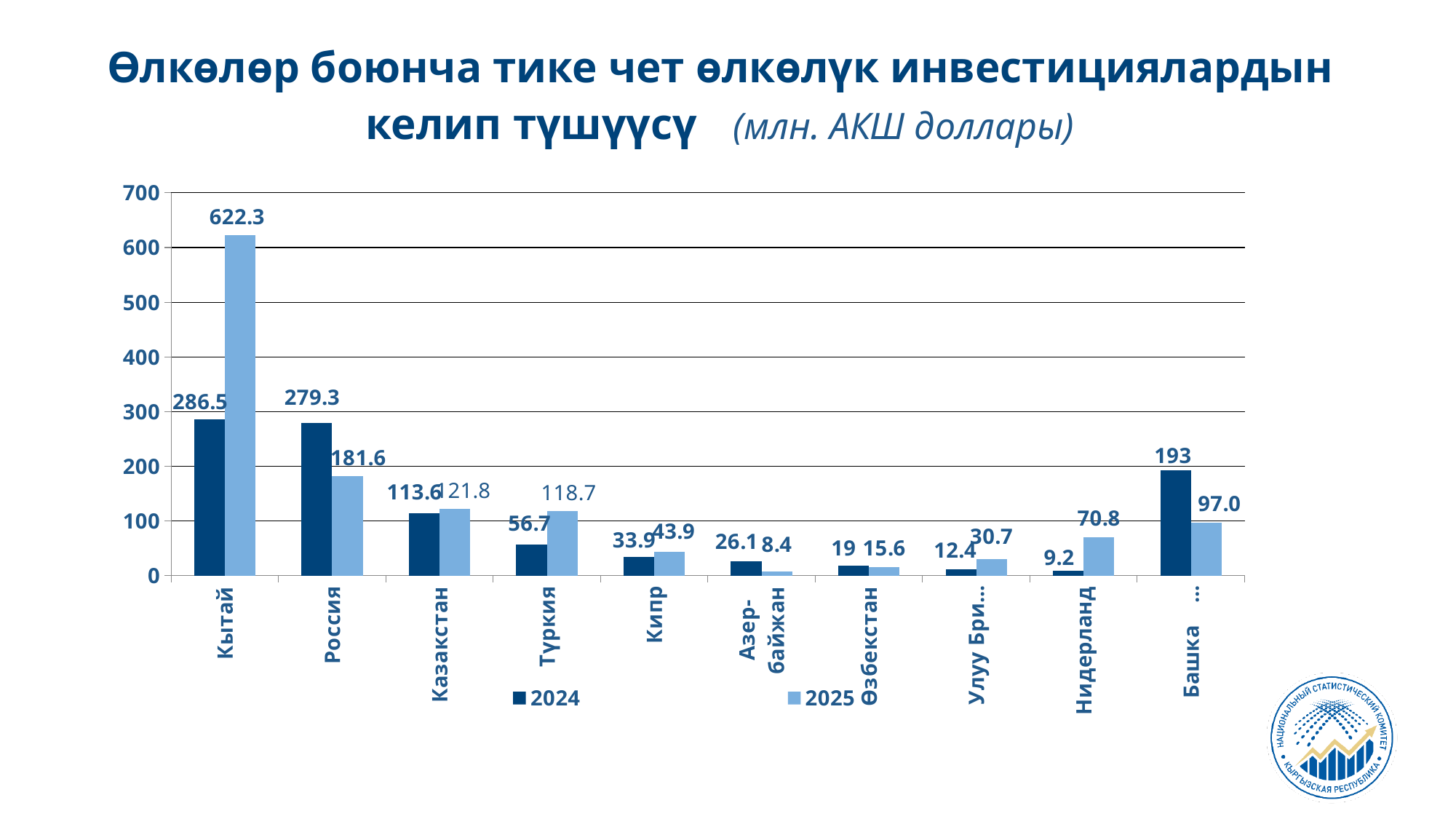
How many countries/categories are shown on the x axis? 10 Which category has the lowest 2024 value? Нидерланд What is the difference between the 2025 and 2024 values for Кытай? 335.8 Which category has the highest 2025 value? Кытай What unit is given in the chart title? млн. АКШ доллары What is the 2024 value for Россия? 279.3 For Россия, which is larger: the 2024 value or the 2025 value? 2024 What type of chart is shown on the slide? bar chart Is the 2024 value for Казакстан greater or less than 100? greater What is the 2025 value for Нидерланд? 70.8 How many series does the legend list? 2 What is the 2025 value for Кытай? 622.3